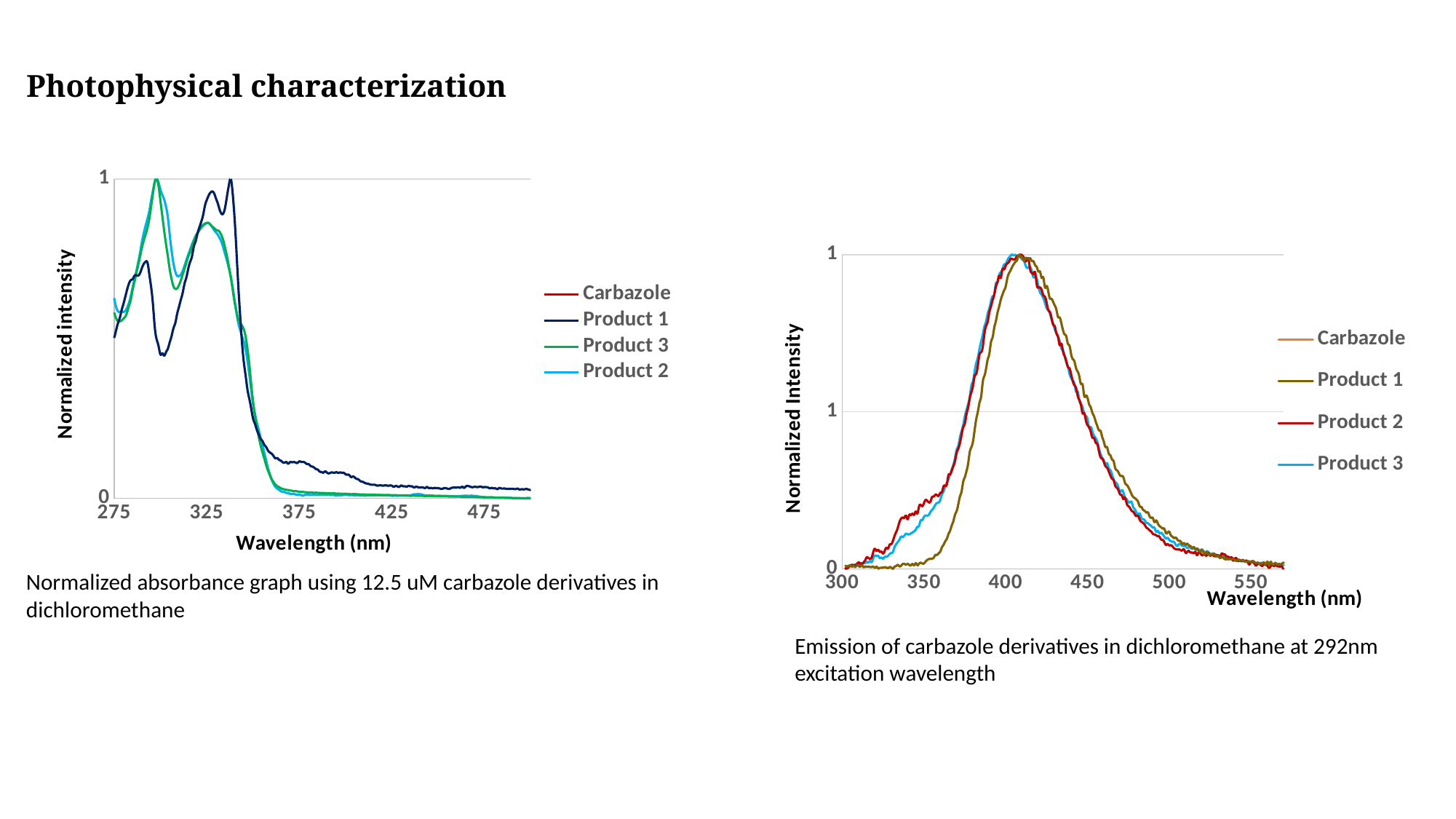
How many series does the legend of the left absorbance chart list? 4 On the right emission chart, do the values of Product 1 rise or fall between 450 nm and 500 nm? fall On the right emission chart, at 350 nm, is the value for Product 2 larger or smaller than the value for Product 1? larger On the left absorbance chart, do the values of Product 1 rise or fall between 350 nm and 375 nm? fall On the left absorbance chart, what is the x-axis title? Wavelength (nm) What kind of chart is the right chart (emission of carbazole derivatives)? line chart How many series does the legend of the right emission chart list? 4 On the right emission chart, which series has the lowest value at 350 nm? Product 1 What kind of chart is the left chart (normalized absorbance)? line chart On the right emission chart, what is the y-axis title? Normalized Intensity On the left absorbance chart, which series has the highest value at 475 nm? Product 1 On the right emission chart, do the values of Product 1 rise or fall between 350 nm and 400 nm? rise